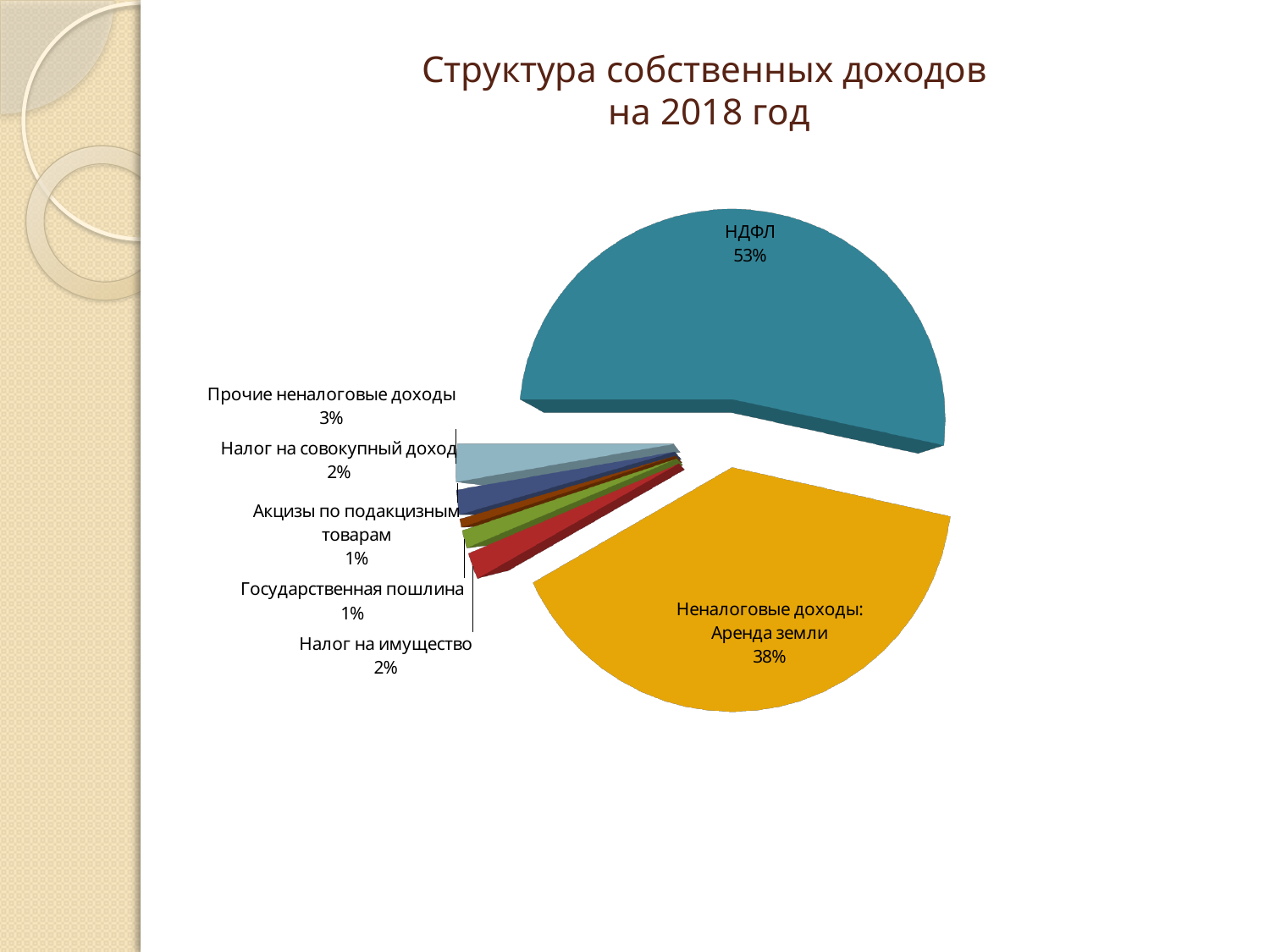
What is the difference in percentage points between НДФЛ and Неналоговые доходы: Аренда земли? 15 Which category has the largest slice of the pie? НДФЛ Which is larger, Прочие неналоговые доходы or Государственная пошлина? Прочие неналоговые доходы How many slices does the pie chart have? 7 What share of the pie does Налог на имущество have? 2% What is the title of the chart? Структура собственных доходов на 2018 год What share of the pie does Неналоговые доходы: Аренда земли have? 38% What share of the pie does Налог на совокупный доход have? 2% What share of the pie does Акцизы по подакцизным товарам have? 1% What share of the pie does НДФЛ have? 53% What share of the pie does Прочие неналоговые доходы have? 3% What kind of chart is shown on the slide? pie chart